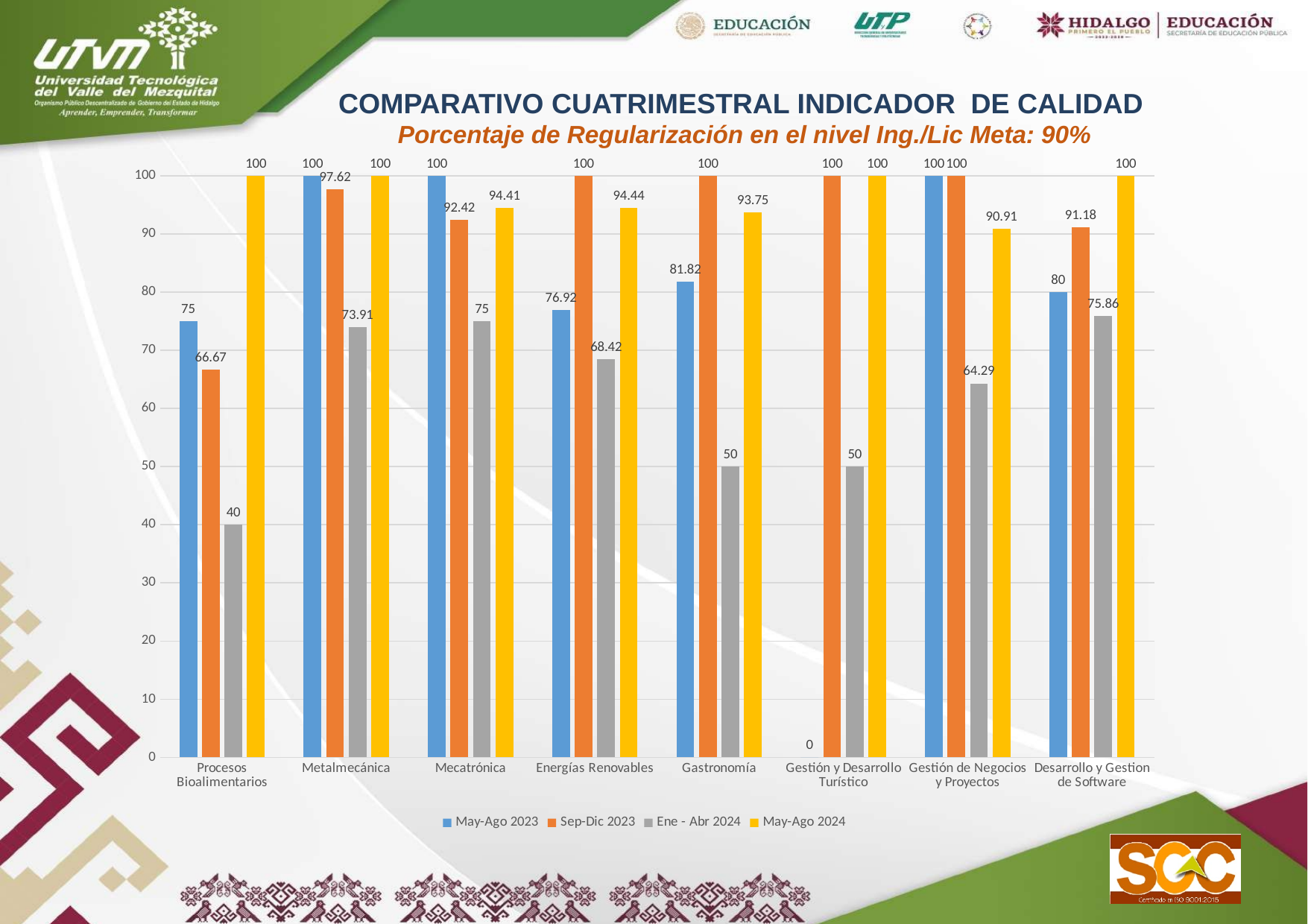
What target (Meta) is stated in the chart subtitle? 90% How many categories are shown on the x axis? 8 How many series does the legend list? 4 Which category has the lowest value in the Ene - Abr 2024 series? Procesos Bioalimentarios What is the difference between the May-Ago 2024 and Ene - Abr 2024 values for Gastronomía? 43.75 What kind of chart is shown on the slide? Bar chart What is the value for Procesos Bioalimentarios in the Ene - Abr 2024 series? 40 What is the value for Metalmecánica in the Sep-Dic 2023 series? 97.62 What is the value for Gestión y Desarrollo Turístico in the May-Ago 2023 series? 0 What is the value for Desarrollo y Gestion de Software in the Ene - Abr 2024 series? 75.86 Which is larger for Energías Renovables: the May-Ago 2023 value or the Ene - Abr 2024 value? May-Ago 2023 Which category has the lowest value in the May-Ago 2024 series? Gestión de Negocios y Proyectos